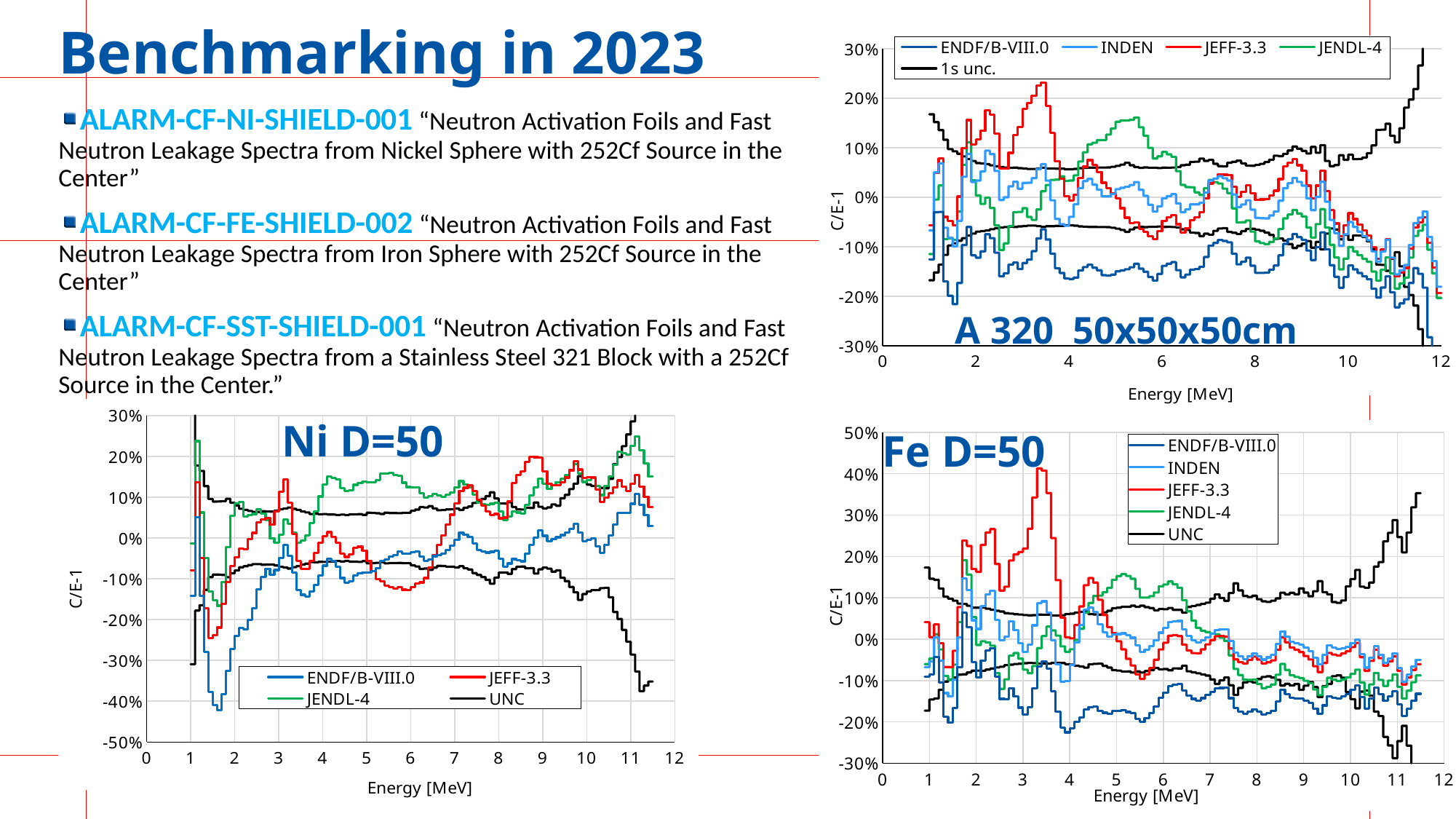
What kind of chart is the Ni D=50 chart? line chart In the Ni D=50 chart, is the value of JENDL-4 near 5.5 MeV greater or less than 10%? greater In the Fe D=50 chart, is the value of ENDF/B-VIII.0 near 4 MeV greater or less than -10%? less How many series does the legend of the Ni D=50 chart list? 4 In the Ni D=50 chart, which series is higher near 5 MeV, JENDL-4 or JEFF-3.3? JENDL-4 In the Fe D=50 chart, which series is higher near 3.5 MeV, JEFF-3.3 or ENDF/B-VIII.0? JEFF-3.3 In the A 320 50x50x50cm chart, is the peak value of JEFF-3.3 near 3.5 MeV greater or less than 10%? greater How many series does the legend of the Fe D=50 chart list? 5 How many series does the legend of the A 320 50x50x50cm chart list? 5 What is the x-axis label of the Fe D=50 chart? Energy [MeV]